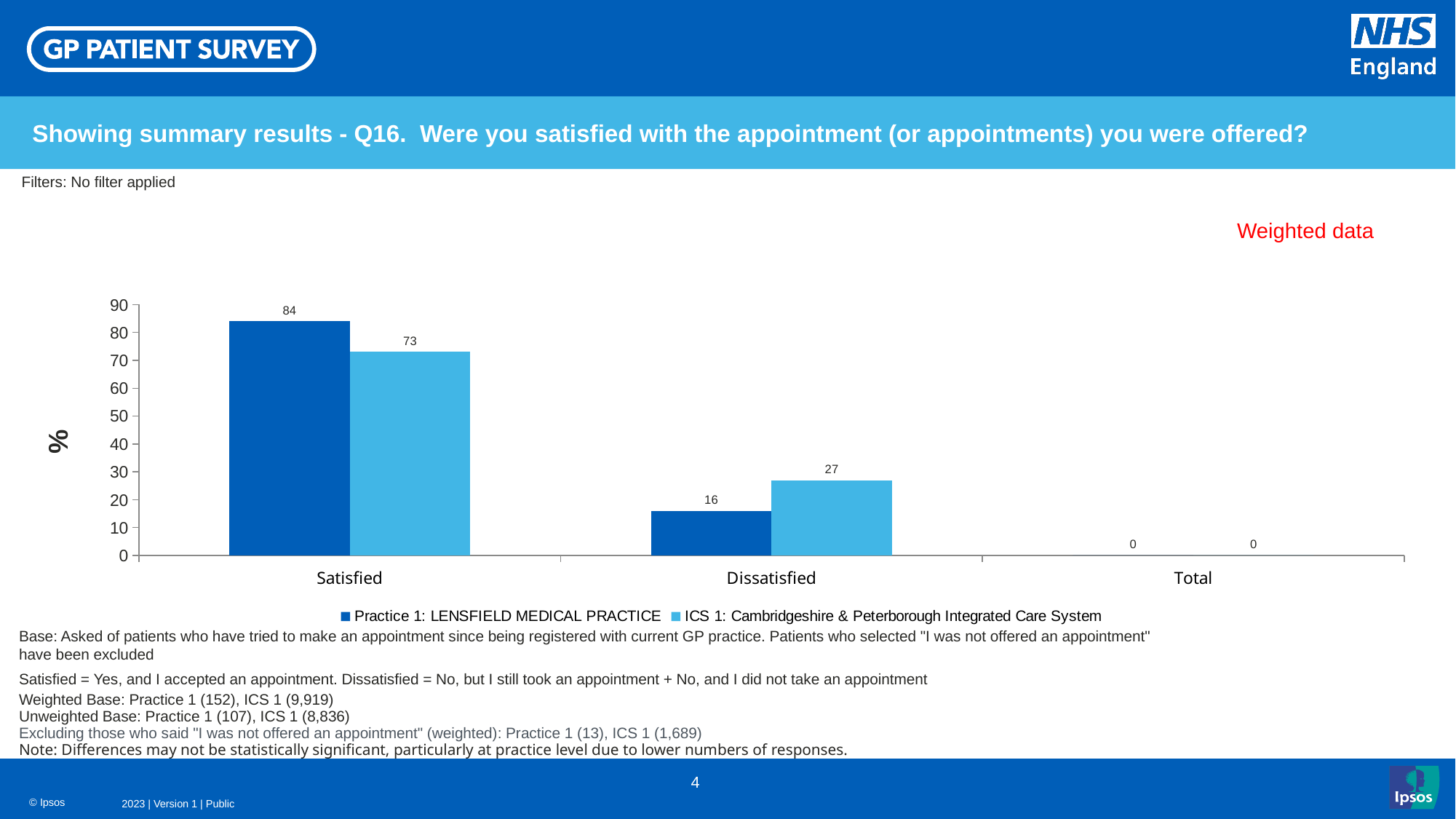
Which series has the larger value in the Dissatisfied category? ICS 1: Cambridgeshire & Peterborough Integrated Care System What is the value for Practice 1: LENSFIELD MEDICAL PRACTICE in the Dissatisfied category? 16 What kind of chart is shown on the slide? Bar chart What is the difference between the Practice 1 and ICS 1 values in the Satisfied category? 11 What is the value for Practice 1: LENSFIELD MEDICAL PRACTICE in the Satisfied category? 84 What is the value for ICS 1: Cambridgeshire & Peterborough Integrated Care System in the Dissatisfied category? 27 What is the label on the vertical axis of the chart? % How many categories are shown on the x axis? 3 How many series does the legend list? 2 Which category has the highest value for Practice 1: LENSFIELD MEDICAL PRACTICE? Satisfied What is the difference between the ICS 1 and Practice 1 values in the Dissatisfied category? 11 What is the value for ICS 1: Cambridgeshire & Peterborough Integrated Care System in the Satisfied category? 73